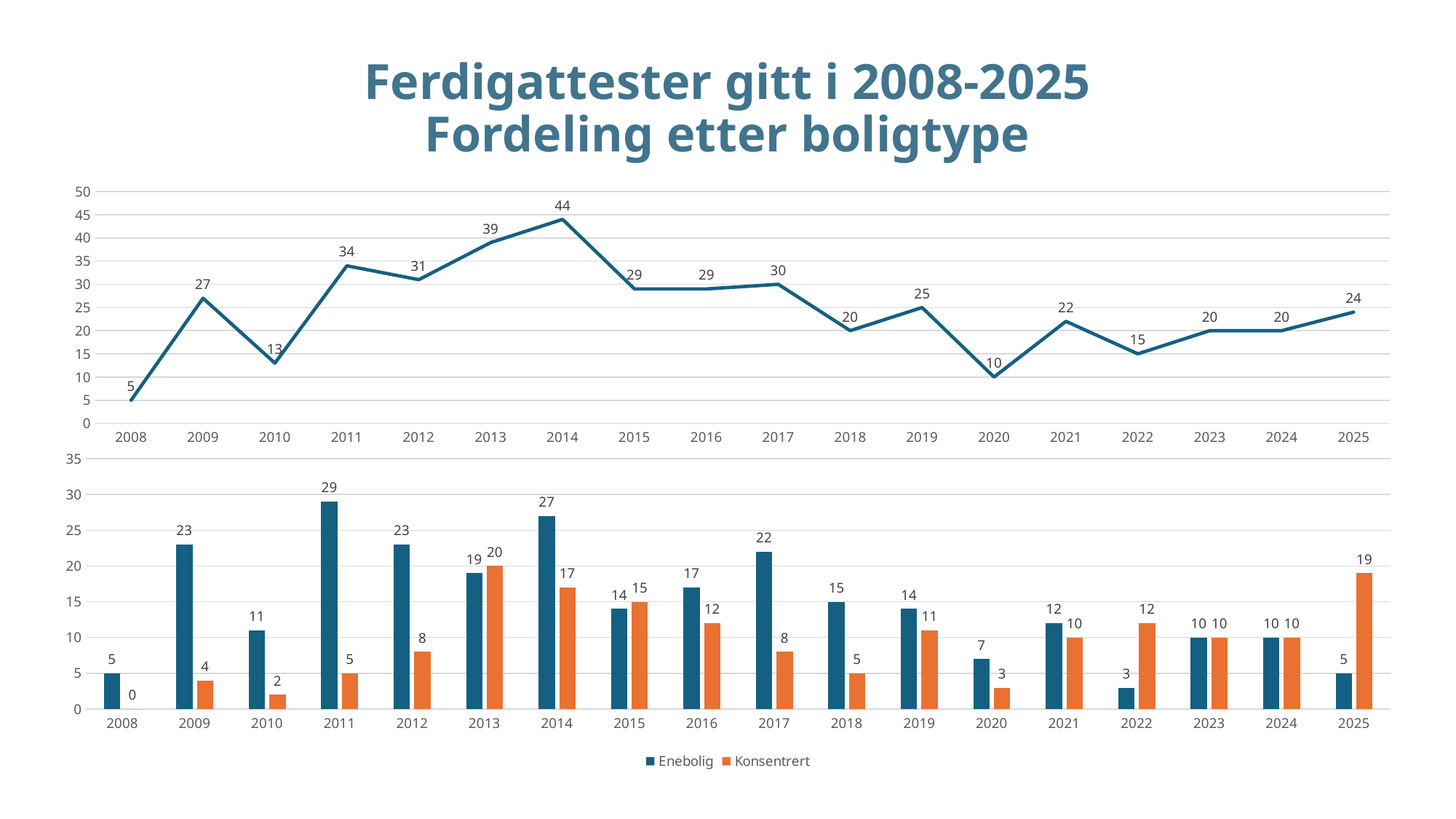
In the top line chart, which year has the highest value? 2014 In the top line chart, what is the difference between the values for 2014 and 2015? 15 In the bottom bar chart, what is the Enebolig value for 2011? 29 In the bottom bar chart, what is the difference between Enebolig and Konsentrert in 2014? 10 What kind of chart is the bottom chart on the slide? Bar chart In the bottom bar chart, which year has the highest Konsentrert value? 2013 In the top line chart, which year has the lowest value? 2008 In the top line chart, how many years are plotted? 18 In the top line chart, what is the value for 2014? 44 In the bottom bar chart, what is the Konsentrert value for 2025? 19 In the bottom bar chart, which is larger for 2022, Enebolig or Konsentrert? Konsentrert How many series does the legend of the bottom chart list? 2